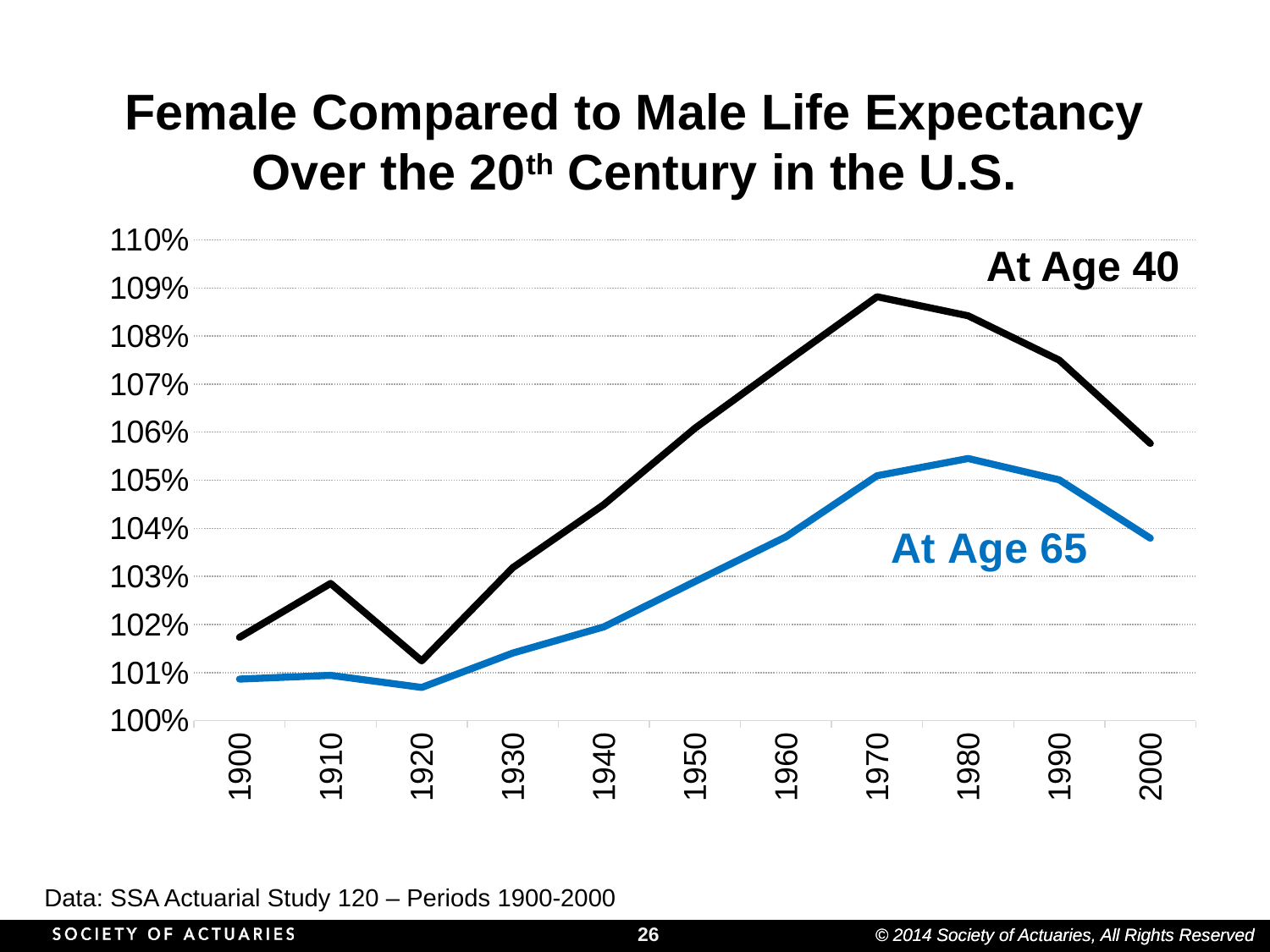
In 1970, which series has the higher value, At Age 40 or At Age 65? At Age 40 Does the At Age 40 line rise or fall between 1970 and 2000? Fall What kind of chart is shown on the slide? Line chart In which year does the At Age 40 line reach its highest value? 1970 Is the At Age 65 value in 2000 greater or less than 105%? less How many years are marked along the x axis of the chart? 11 Is the At Age 65 value in 1960 greater or less than 103%? greater Is the At Age 40 value in 2000 greater or less than 105%? greater What colour is the At Age 65 line? Blue Does the At Age 65 line rise or fall between 1920 and 1970? Rise How many series are plotted on the chart? 2